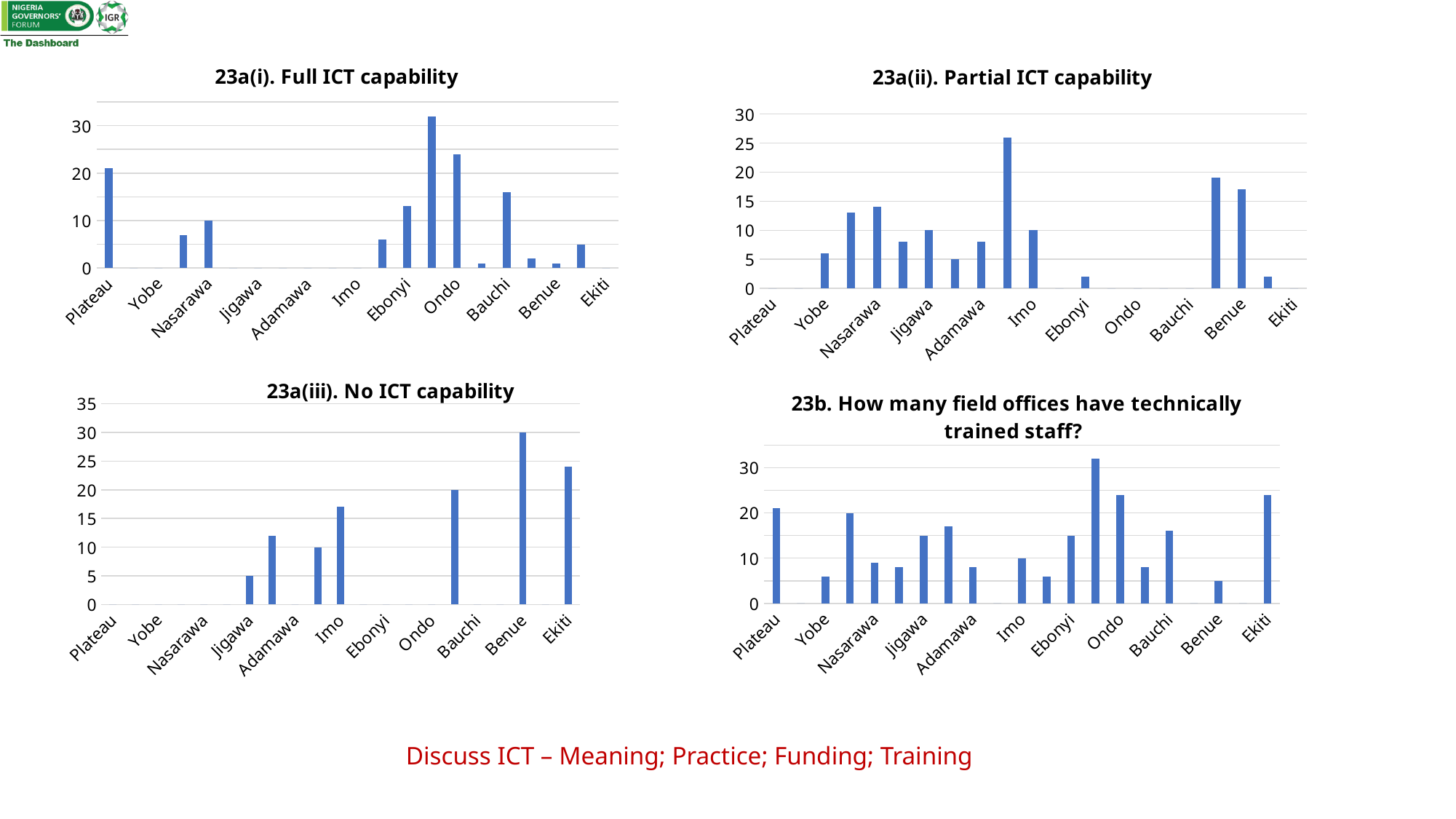
In the '23a(iii). No ICT capability' chart, is the value for Jigawa greater or less than 10? less In the '23b. How many field offices have technically trained staff?' chart, is the value for Benue greater or less than 10? less How many charts are shown on the slide? 4 In the '23a(i). Full ICT capability' chart, is the value for Ondo greater or less than 30? less In the '23a(iii). No ICT capability' chart, which state has the tallest bar? Benue What kind of chart is '23a(i). Full ICT capability'? bar chart